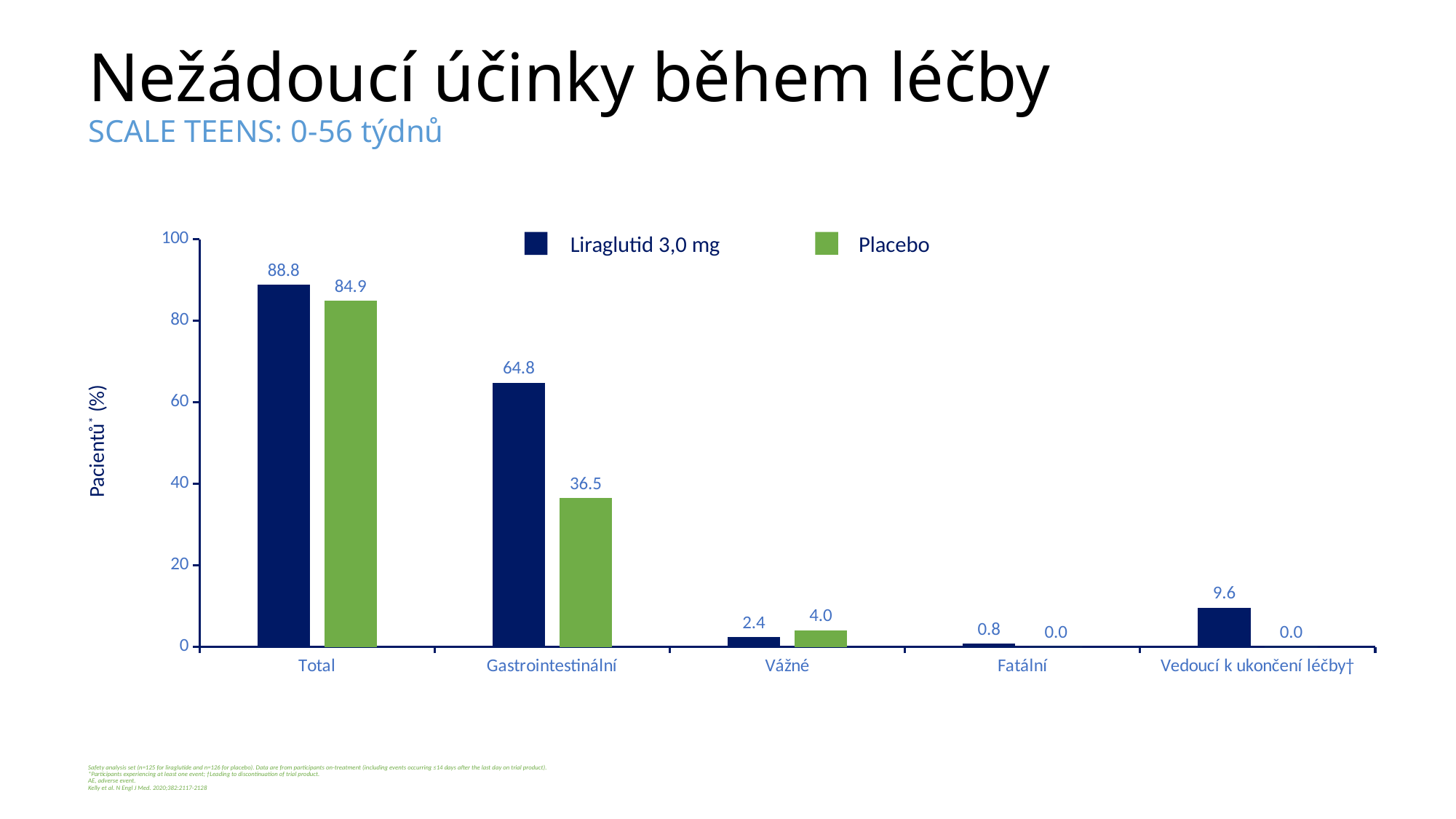
What kind of chart is shown on the slide? Bar chart How many categories are shown on the x axis? 5 What is the value for Placebo in the Fatální category? 0.0 Which category has the lowest value for Liraglutid 3,0 mg? Fatální What is the label of the y axis? Pacientů* (%) In the Vážné category, which series has the larger value, Liraglutid 3,0 mg or Placebo? Placebo What is the difference between Liraglutid 3,0 mg and Placebo in the Gastrointestinální category? 28.3 What is the value for Placebo in the Gastrointestinální category? 36.5 What is the value for Liraglutid 3,0 mg in the Total category? 88.8 How many series does the legend list? 2 What is the value for Liraglutid 3,0 mg in the Vedoucí k ukončení léčby† category? 9.6 Which category has the highest value for Placebo? Total